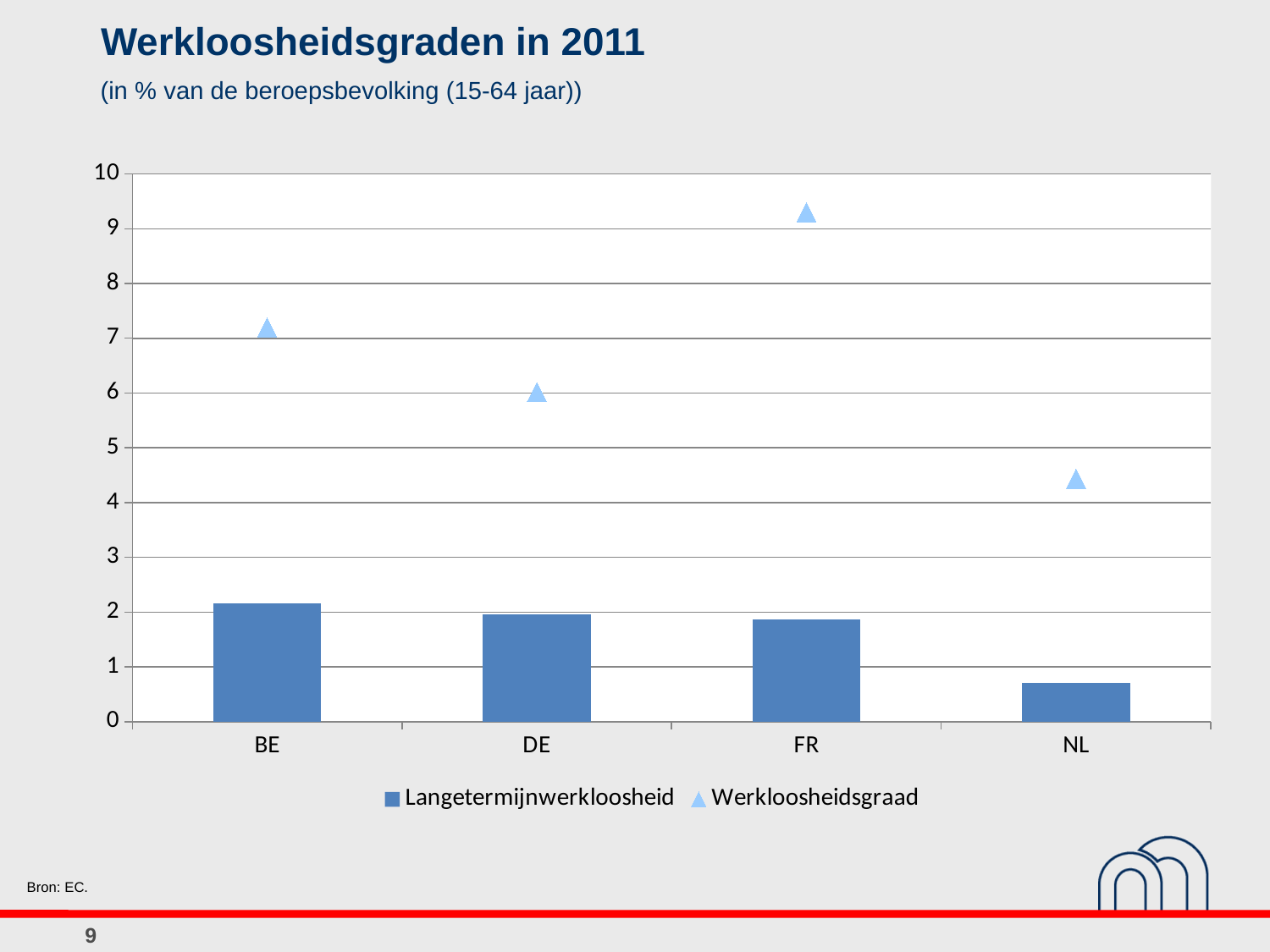
Is the Langetermijnwerkloosheid for NL greater or less than 1? less How many series does the legend list? 2 Which country has the lowest Werkloosheidsgraad? NL Is the Langetermijnwerkloosheid for BE greater or less than 2? greater Which country has the lowest Langetermijnwerkloosheid? NL Which country has the highest Werkloosheidsgraad? FR Which series is shown with triangle markers? Werkloosheidsgraad How many countries are shown on the x axis? 4 Which is larger, the Werkloosheidsgraad for FR or for DE? FR Is the Werkloosheidsgraad for NL greater or less than 5? less Which country has the highest Langetermijnwerkloosheid? BE